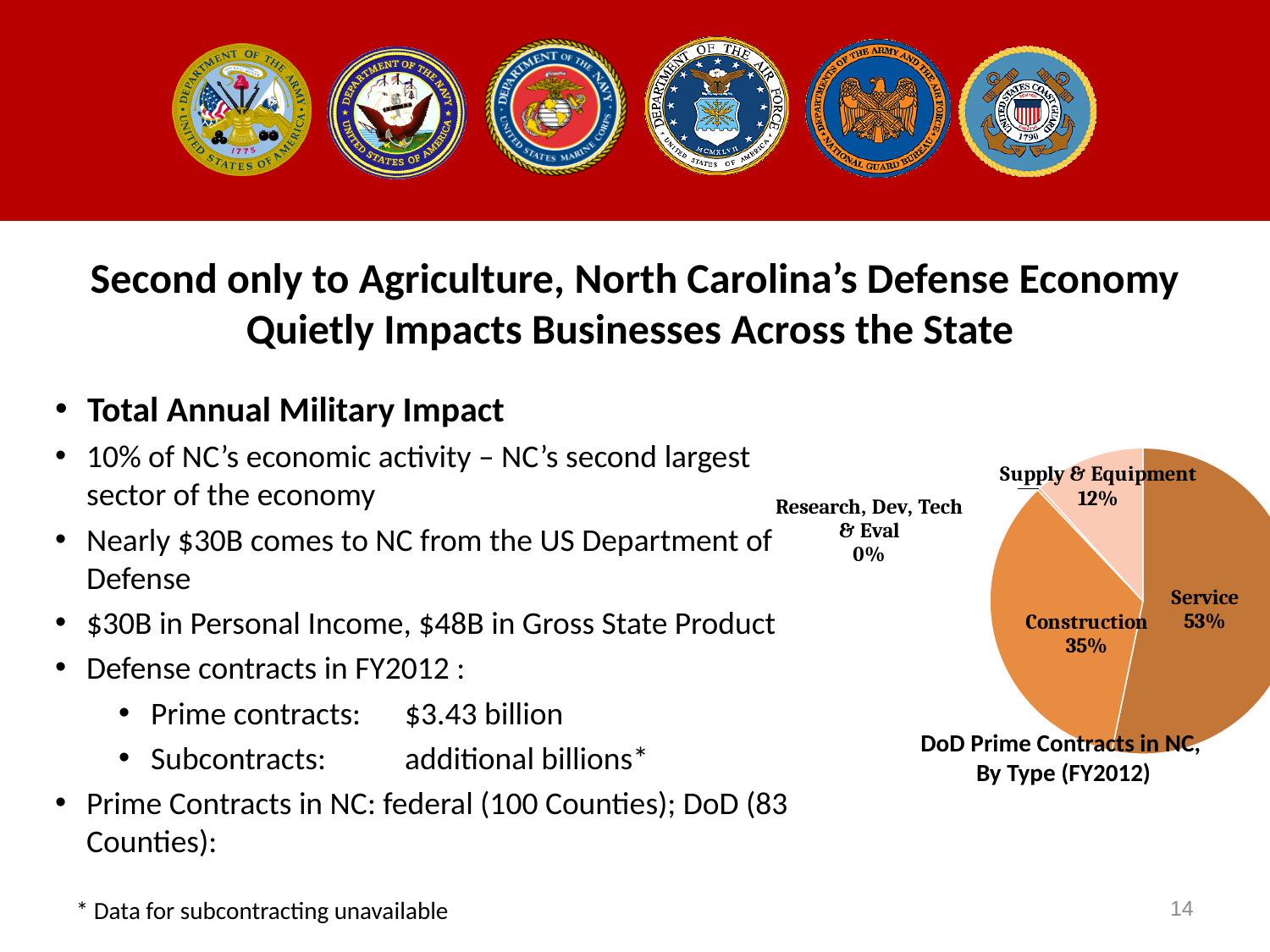
What share of DoD prime contracts in NC is Construction? 35% What share of DoD prime contracts in NC is Supply & Equipment? 12% What share of DoD prime contracts in NC is Service? 53% How many contract types are shown in the pie chart? 4 Which contract type has the largest share of the pie? Service What is the difference in percentage points between the Service and Construction shares? 18 Which contract type has the smallest share of the pie? Research, Dev, Tech & Eval What is the title of the chart on the slide? DoD Prime Contracts in NC, By Type (FY2012) What share of DoD prime contracts in NC is Research, Dev, Tech & Eval? 0% What kind of chart is shown on the slide? pie chart What is the combined share of Service and Construction? 88% Which is larger, the Construction share or the Supply & Equipment share? Construction